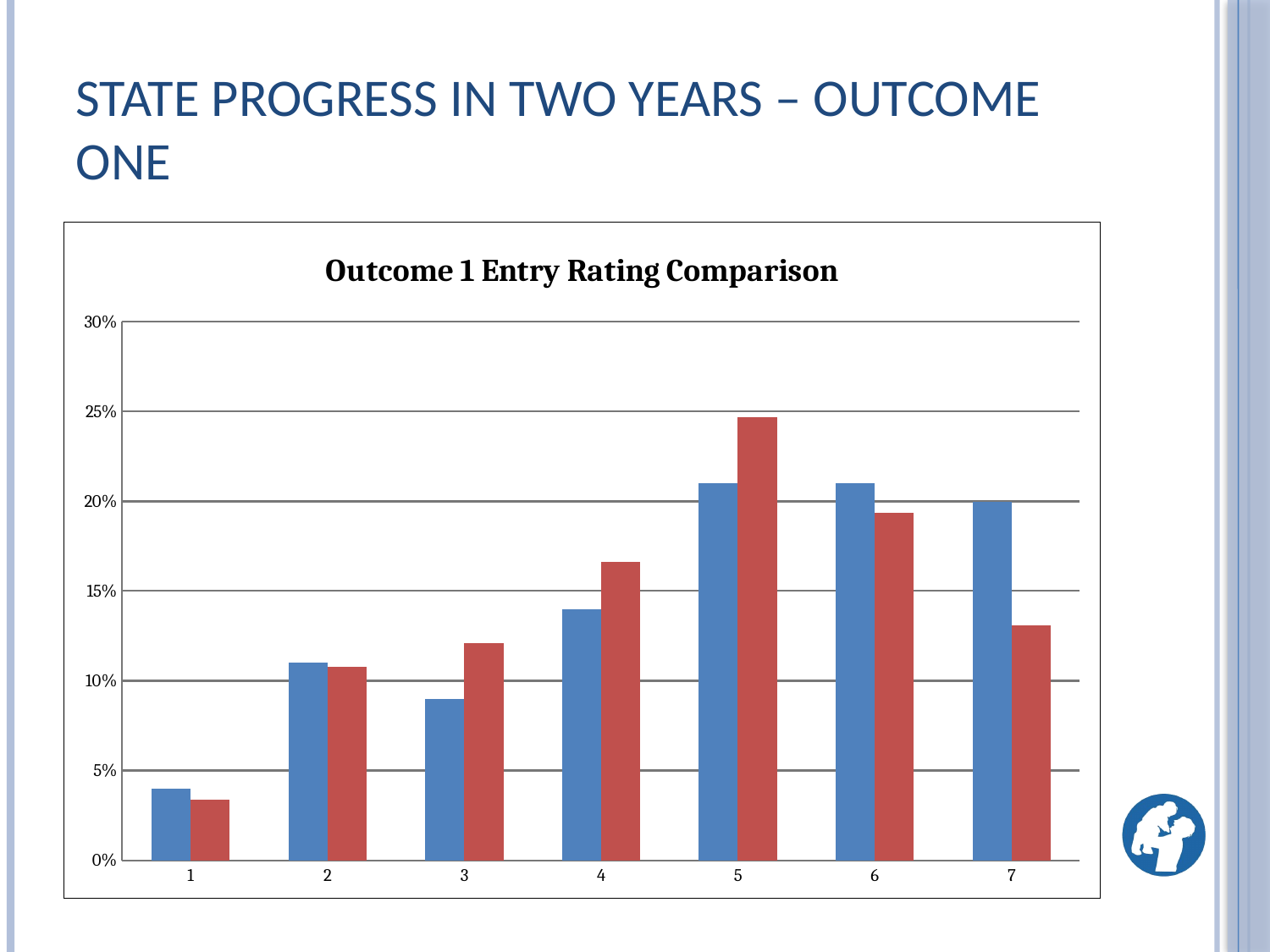
For category 7, which bar is taller, the blue one or the red one? blue Is the blue bar for category 3 greater or less than 10%? less How many categories are shown on the x axis of the chart? 7 Is the red bar for category 7 greater or less than 15%? less What is the title of the chart? Outcome 1 Entry Rating Comparison How many bar colours (series) are plotted for each category? 2 Which category has the tallest red bar? 5 What kind of chart is shown on the slide? bar chart Which category has the shortest red bar? 1 Is the red bar for category 5 greater or less than 20%? greater Which category has the shortest blue bar? 1 For category 4, which bar is taller, the blue one or the red one? red